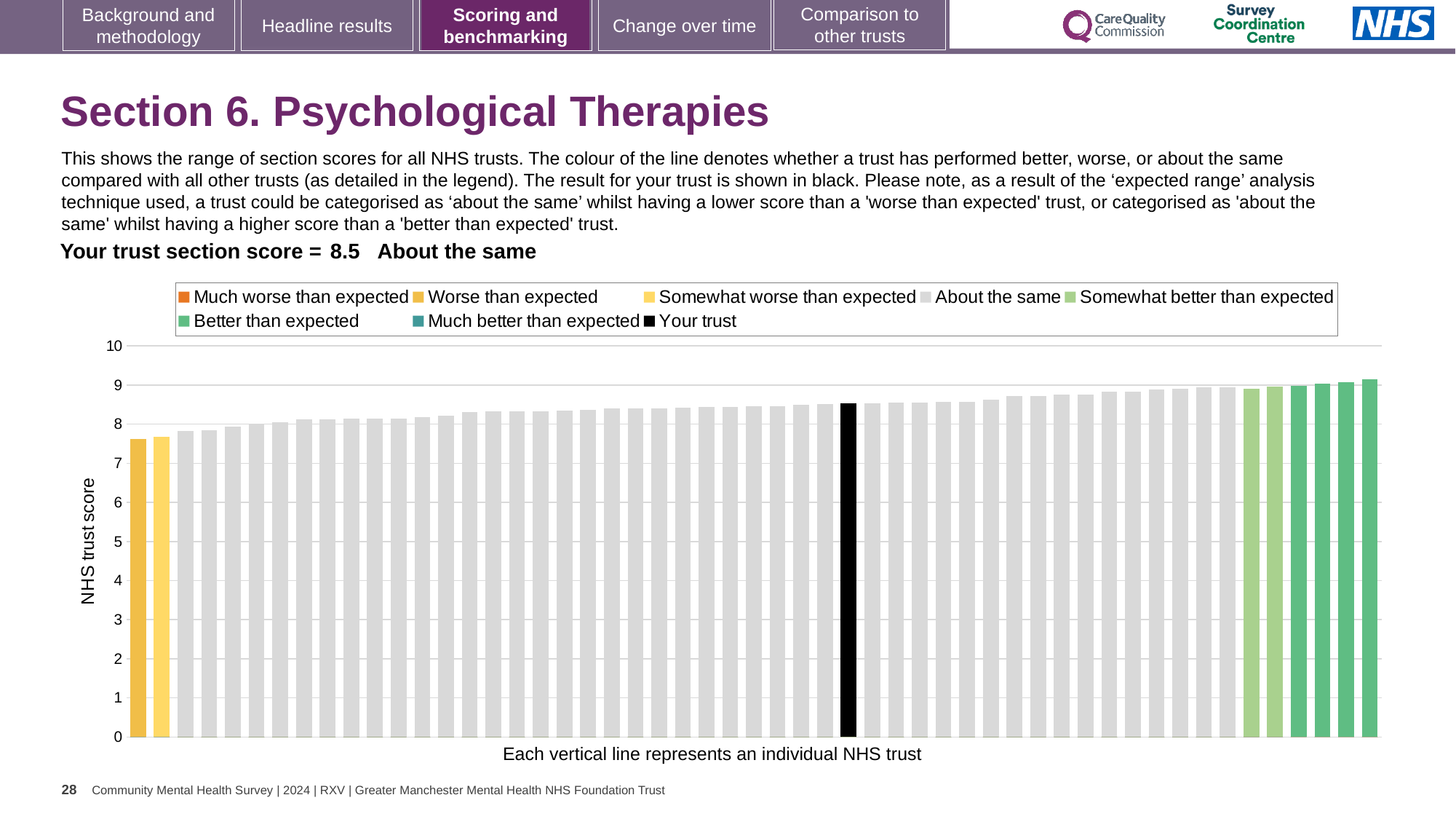
Is the value for your trust (the black bar) greater or less than 8? greater What kind of chart is shown on the slide? bar chart Is the value for your trust (the black bar) greater or less than 9? less Which category is your trust placed in for this section? About the same Is the value of the leftmost (lowest) bar greater or less than 7? greater What is the title of the vertical axis? NHS trust score How many entries does the chart legend list? 8 How many bars are coloured as 'Worse than expected'? 1 Do the bar values rise or fall from left to right along the x axis? rise What is the section score for your trust shown on the slide? 8.5